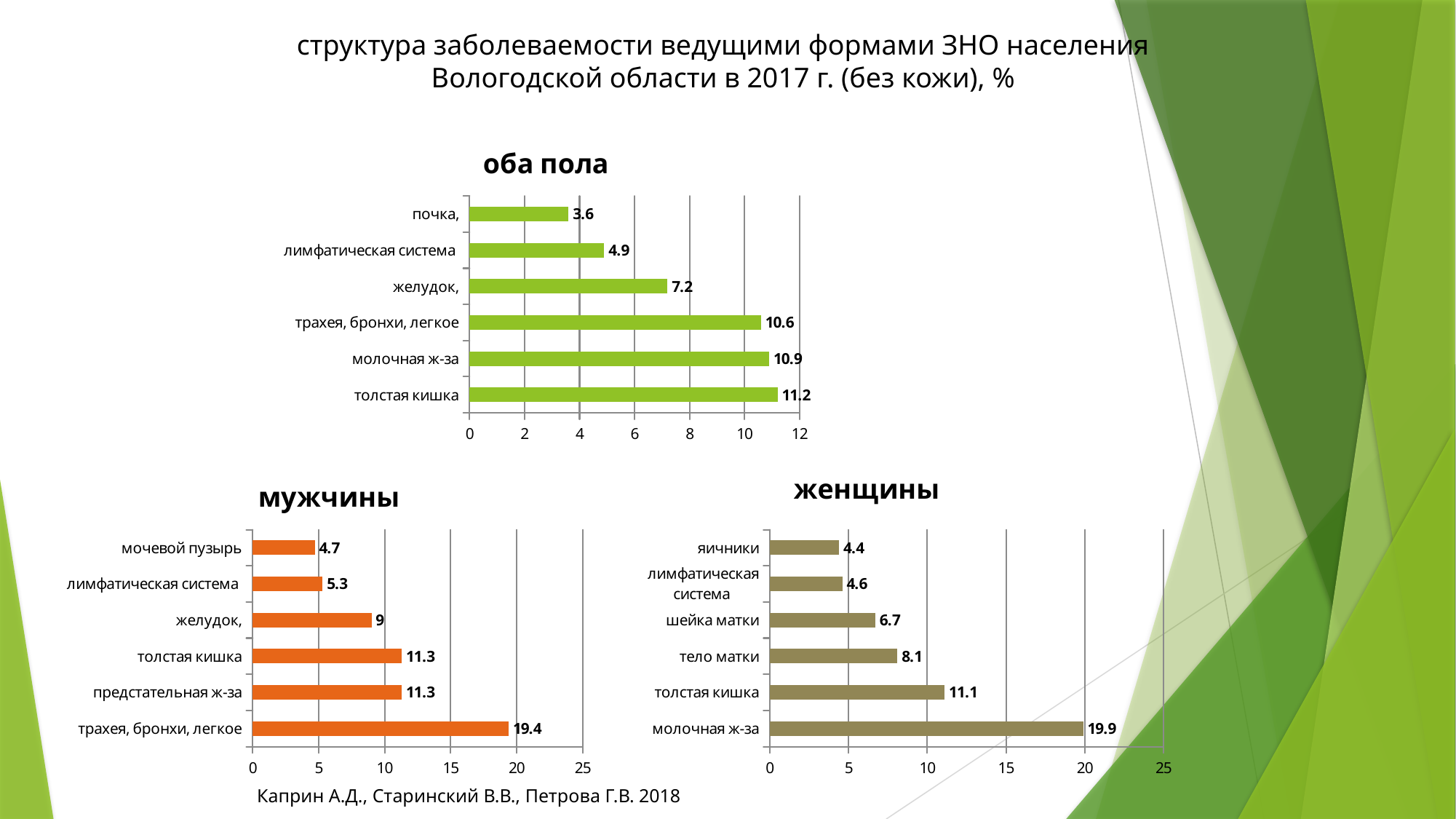
In the 'женщины' chart, what is the value for молочная ж-за? 19.9 In the 'женщины' chart, which category has the lowest value? яичники In the 'оба пола' chart, which category has the lowest value? почка In the 'мужчины' chart, what is the value for трахея, бронхи, легкое? 19.4 In the 'мужчины' chart, what is the value for желудок? 9 In the 'оба пола' chart, how many categories are shown? 6 In the 'мужчины' chart, which is larger: the value for лимфатическая система or the value for мочевой пузырь? лимфатическая система In the 'оба пола' chart, what is the difference between the values for трахея, бронхи, легкое and желудок? 3.4 In the 'женщины' chart, what is the difference between the values for тело матки and шейка матки? 1.4 In the 'оба пола' chart, what is the value for толстая кишка? 11.2 What kind of chart is the 'женщины' chart? bar chart In the 'мужчины' chart, which category has the highest value? трахея, бронхи, легкое